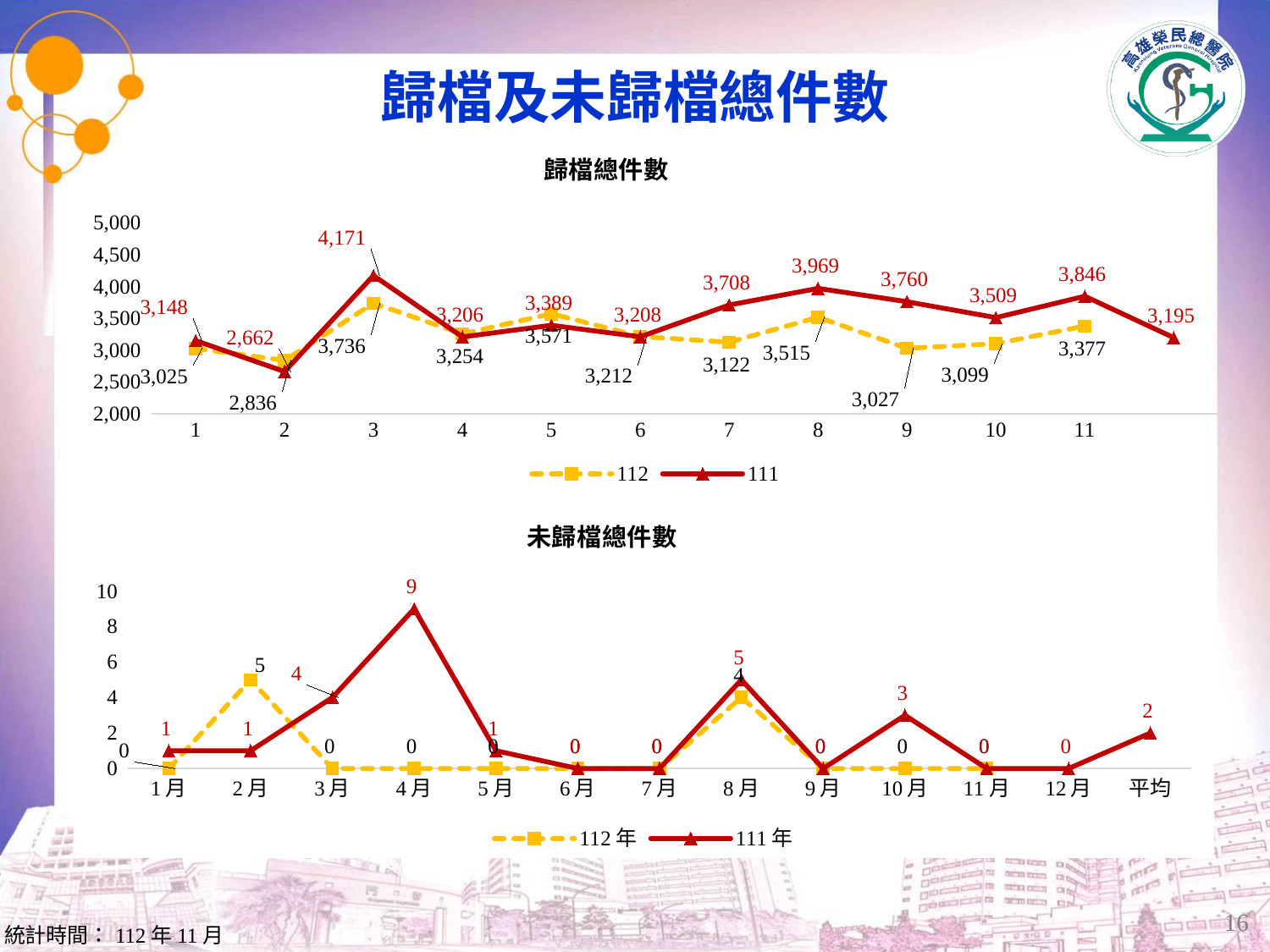
How many series does the legend of the top chart (歸檔總件數) list? 2 In the bottom chart (未歸檔總件數), what is the value of series 111年 for 4月? 9 In the top chart (歸檔總件數), at which x-axis point does series 111 reach its highest value? 3 In the top chart (歸檔總件數), what is the difference between series 111 and series 112 at point 3? 435 What type of chart is the top chart (歸檔總件數)? Line chart In the top chart (歸檔總件數), at which x-axis point does series 112 have its lowest value? 2 In the bottom chart (未歸檔總件數), what is the value of series 112年 for 2月? 5 In the top chart (歸檔總件數), which series has the larger value at point 5? 112 In the top chart (歸檔總件數), what is the value of series 112 at point 8? 3,515 In the bottom chart (未歸檔總件數), which series has the larger value for 8月? 111年 In the bottom chart (未歸檔總件數), how many categories are shown on the x axis? 13 In the top chart (歸檔總件數), what is the value of series 111 at point 3? 4,171